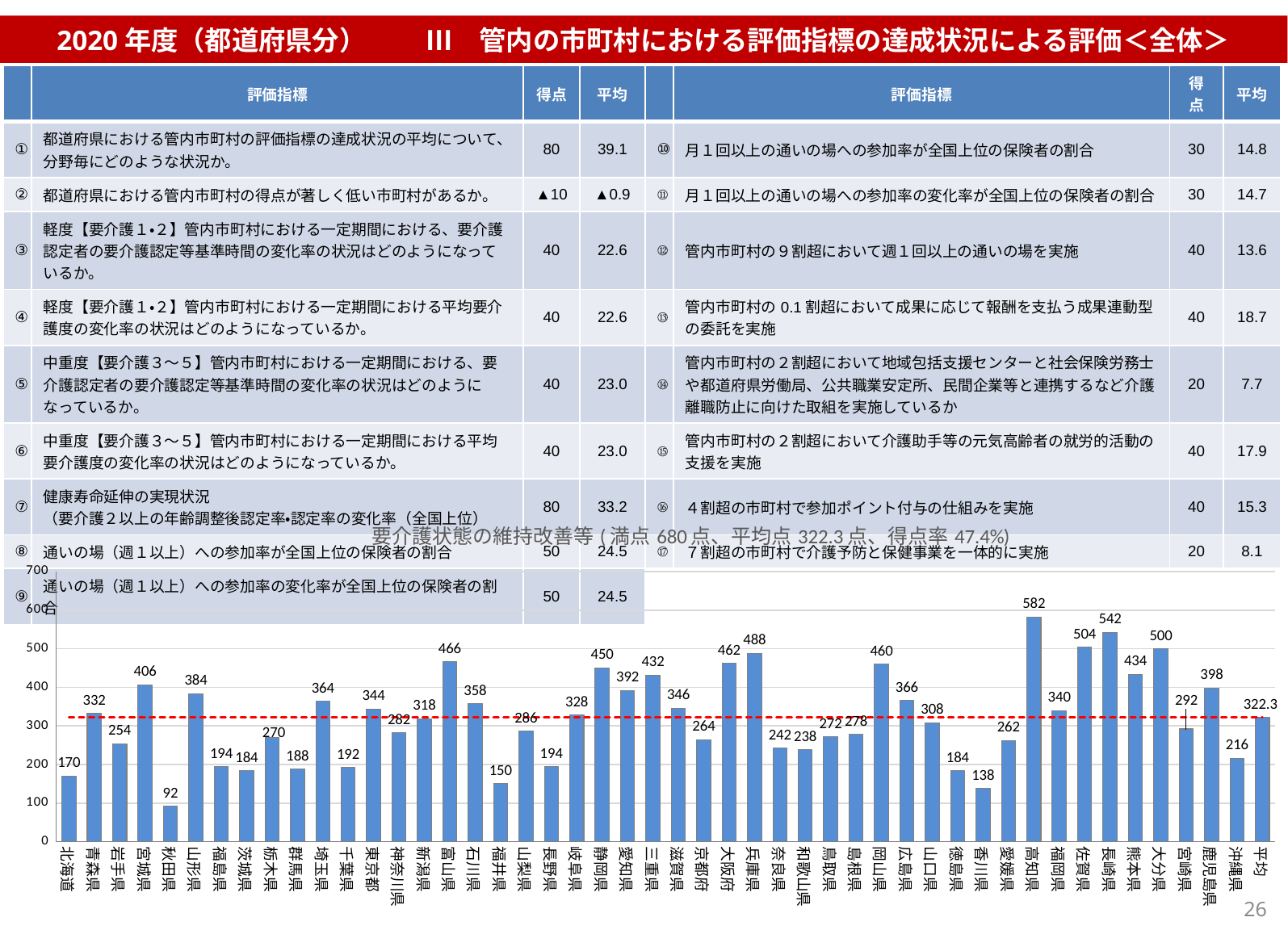
What is the difference between the values for 長崎県 and 佐賀県 in the bar chart? 38 What kind of chart is shown at the bottom of the slide? Bar chart What is the 満点 (full score) stated in the bar chart's title? 680 点 What is the difference between the values for 北海道 and 青森県 in the bar chart? 162 What is the value for 秋田県 in the bar chart? 92 What is the value for 高知県 in the bar chart? 582 Which prefecture has the highest value in the bar chart? 高知県 Which has a larger value in the bar chart, 兵庫県 or 大阪府? 兵庫県 Which prefecture has the lowest value in the bar chart? 秋田県 How many bars are plotted in the bar chart, including 平均? 48 What is the value for 香川県 in the bar chart? 138 What is the value shown for 平均 at the right end of the bar chart? 322.3